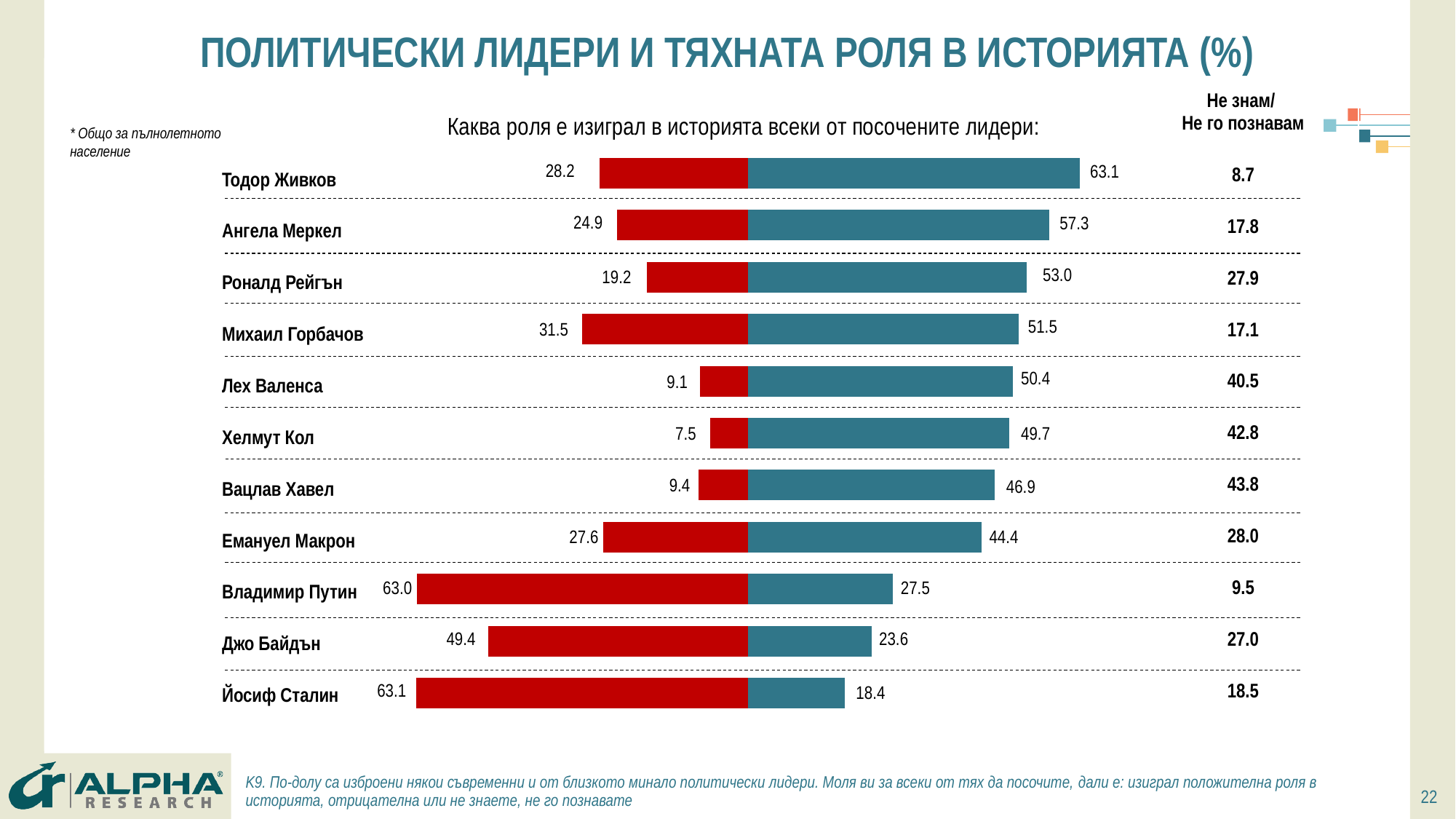
Which leader has the highest teal bar value? Тодор Живков What type of chart is shown on the slide? Bar chart What is the value shown in the 'Не знам/Не го познавам' column for Лех Валенса? 40.5 What is the difference between the red bar value and the teal bar value for Михаил Горбачов? 20.0 Which leader has the highest value in the 'Не знам/Не го познавам' column? Вацлав Хавел What is the value of the red bar for Владимир Путин? 63.0 Which is larger, the red bar value for Джо Байдън or the red bar value for Емануел Макрон? Джо Байдън Which leader has the lowest red bar value? Хелмут Кол What is the difference between the teal bar values for Ангела Меркел and Роналд Рейгън? 4.3 How many leaders are listed in the chart? 11 What is the value of the teal bar for Тодор Живков? 63.1 Which leader has the lowest teal bar value? Йосиф Сталин